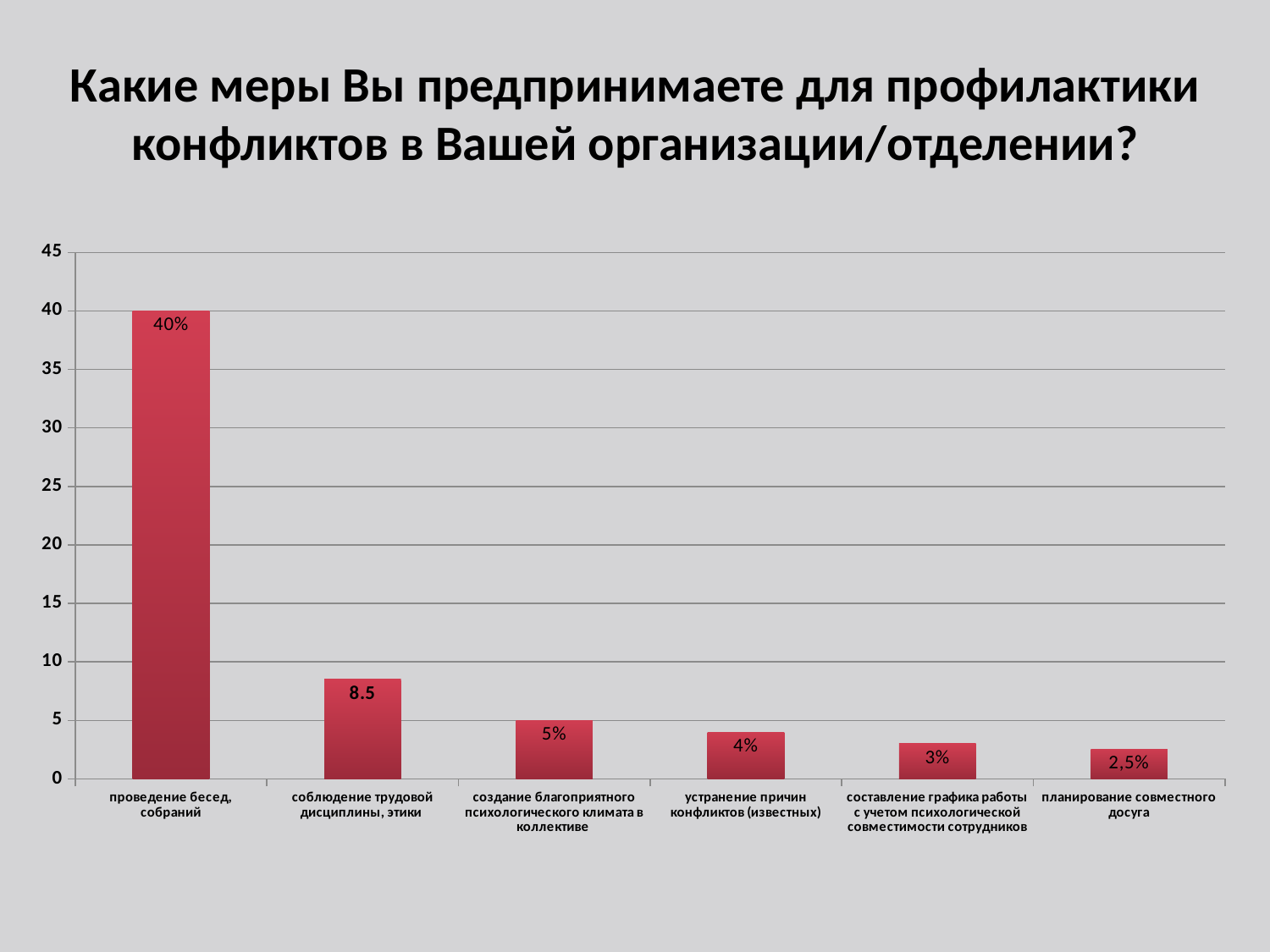
Is the value for «соблюдение трудовой дисциплины, этики» greater or less than 10? less Which category has the highest value? проведение бесед, собраний What is the difference between the values for «проведение бесед, собраний» and «устранение причин конфликтов (известных)»? 36% How many categories are shown on the x axis? 6 What kind of chart is shown on the slide? bar chart What value is shown for «проведение бесед, собраний»? 40% Which is larger: the value for «устранение причин конфликтов (известных)» or for «составление графика работы с учетом психологической совместимости сотрудников»? устранение причин конфликтов (известных) Do the values rise or fall from left to right along the x axis? fall What value is shown for «планирование совместного досуга»? 2,5% Which category has the lowest value? планирование совместного досуга What value is shown for «создание благоприятного психологического климата в коллективе»? 5% What value is shown for «соблюдение трудовой дисциплины, этики»? 8.5